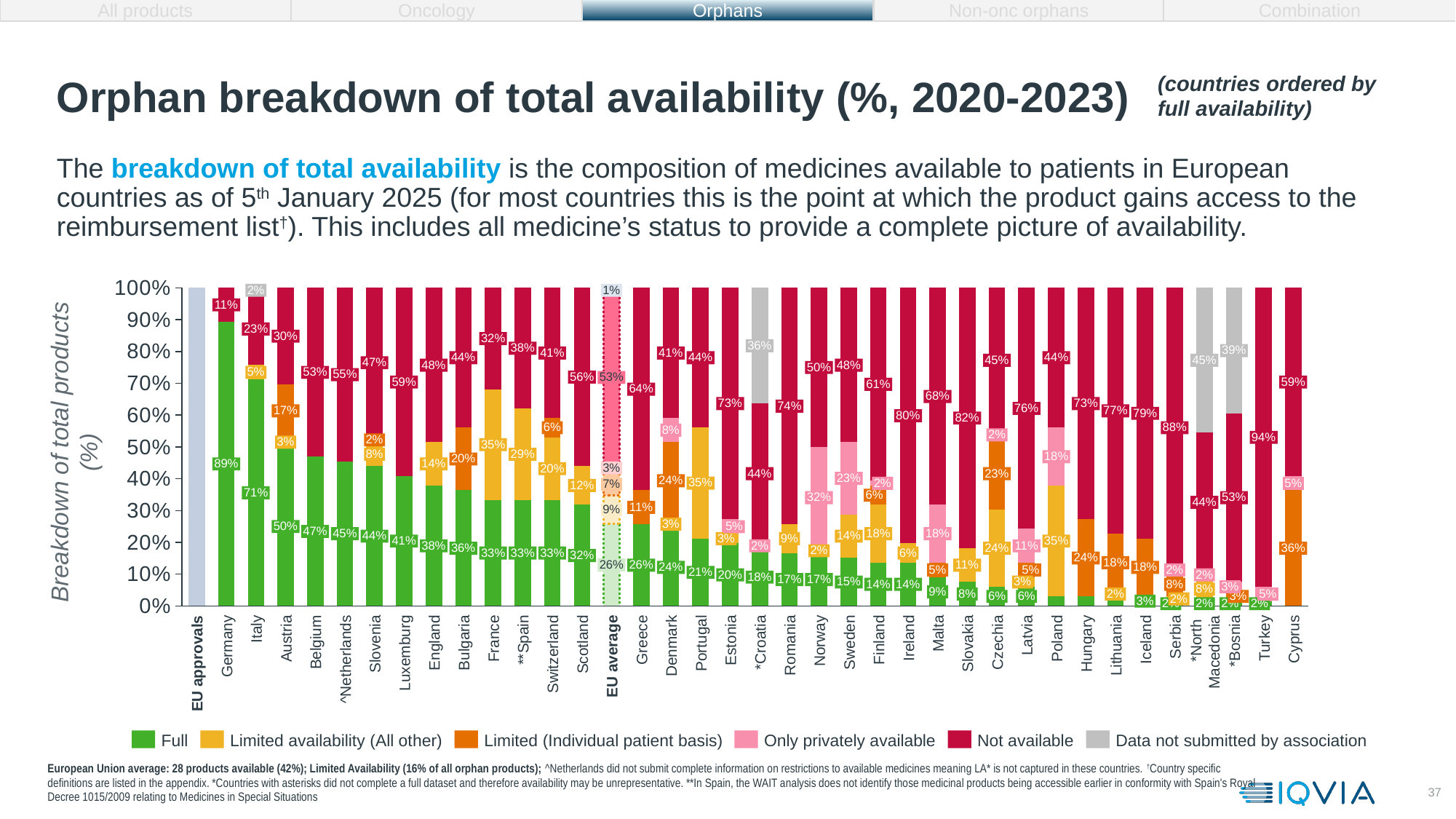
Which has a larger Not available value, Ireland or Slovakia? Slovakia Which legend entry is shown in grey? Data not submitted by association What type of chart is shown on the slide? Stacked bar chart Which country has the highest Full availability value? Germany What is the Full availability value for the EU average? 26% How many series does the legend list? 6 What is the Only privately available value for Norway? 32% What is the Data not submitted by association value for *North Macedonia? 45% What is the Limited (Individual patient basis) value for Cyprus? 36% What is the difference between the Full availability values for Germany and Italy? 18% What is the Full availability value for Germany? 89% What is the Not available value for Turkey? 94%